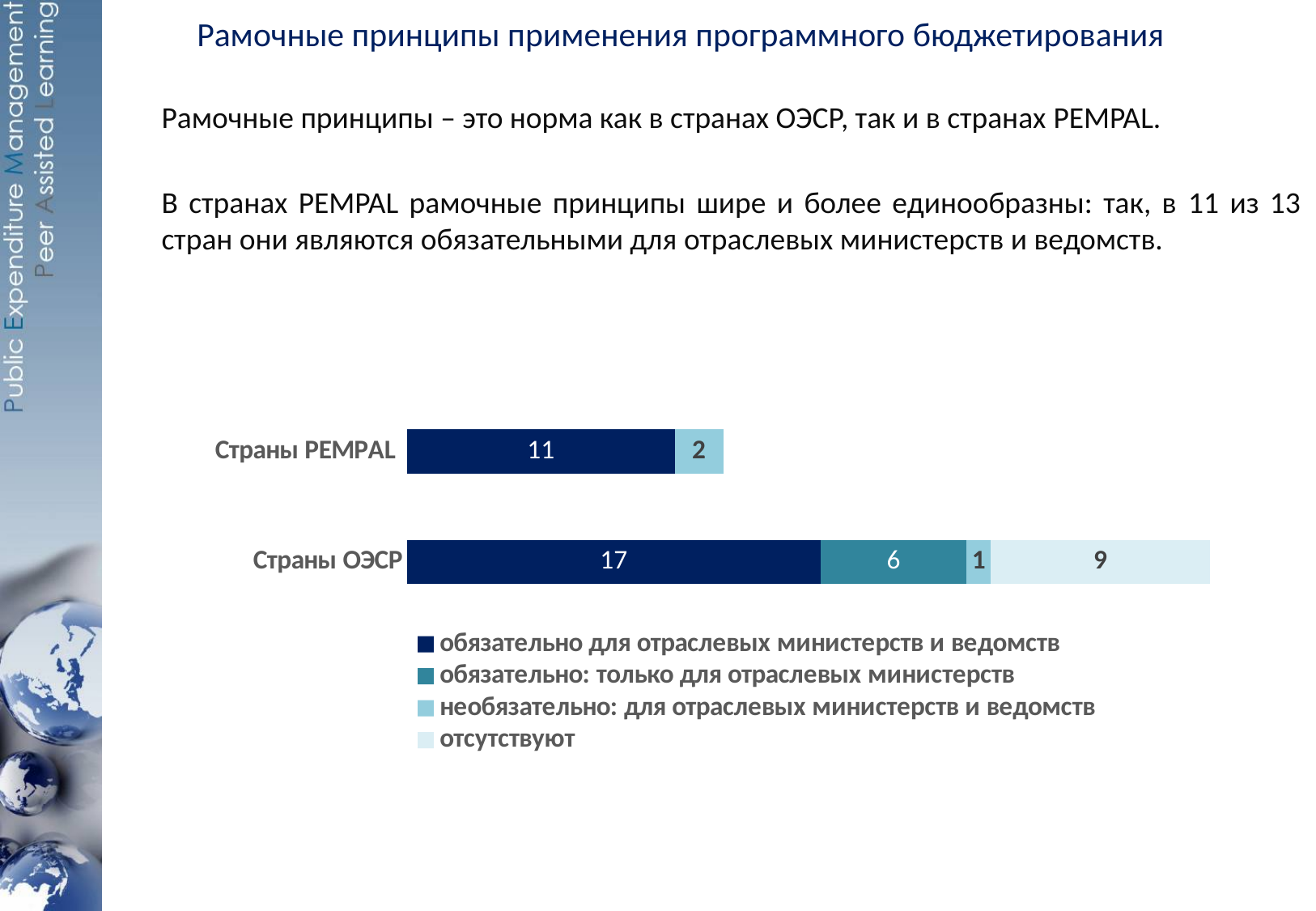
Каково значение «необязательно: для отраслевых министерств и ведомств» для стран PEMPAL? 2 Какой тип диаграммы показан на слайде? Столбчатая (линейчатая) диаграмма с накоплением Какой ряд данных в легенде обозначен самым светлым цветом? отсутствуют Каково значение «отсутствуют» для стран ОЭСР? 9 Каково значение «обязательно для отраслевых министерств и ведомств» для стран ОЭСР? 17 На сколько значение «обязательно для отраслевых министерств и ведомств» для стран ОЭСР больше, чем для стран PEMPAL? 6 Каково значение «обязательно для отраслевых министерств и ведомств» для стран PEMPAL? 11 Какова общая сумма значений в столбце «Страны PEMPAL»? 13 Сколько категорий (стран/групп) показано на диаграмме? 2 Каково значение «обязательно: только для отраслевых министерств» для стран ОЭСР? 6 Какова общая сумма значений в столбце «Страны ОЭСР»? 33 Сколько рядов данных перечислено в легенде диаграммы? 4